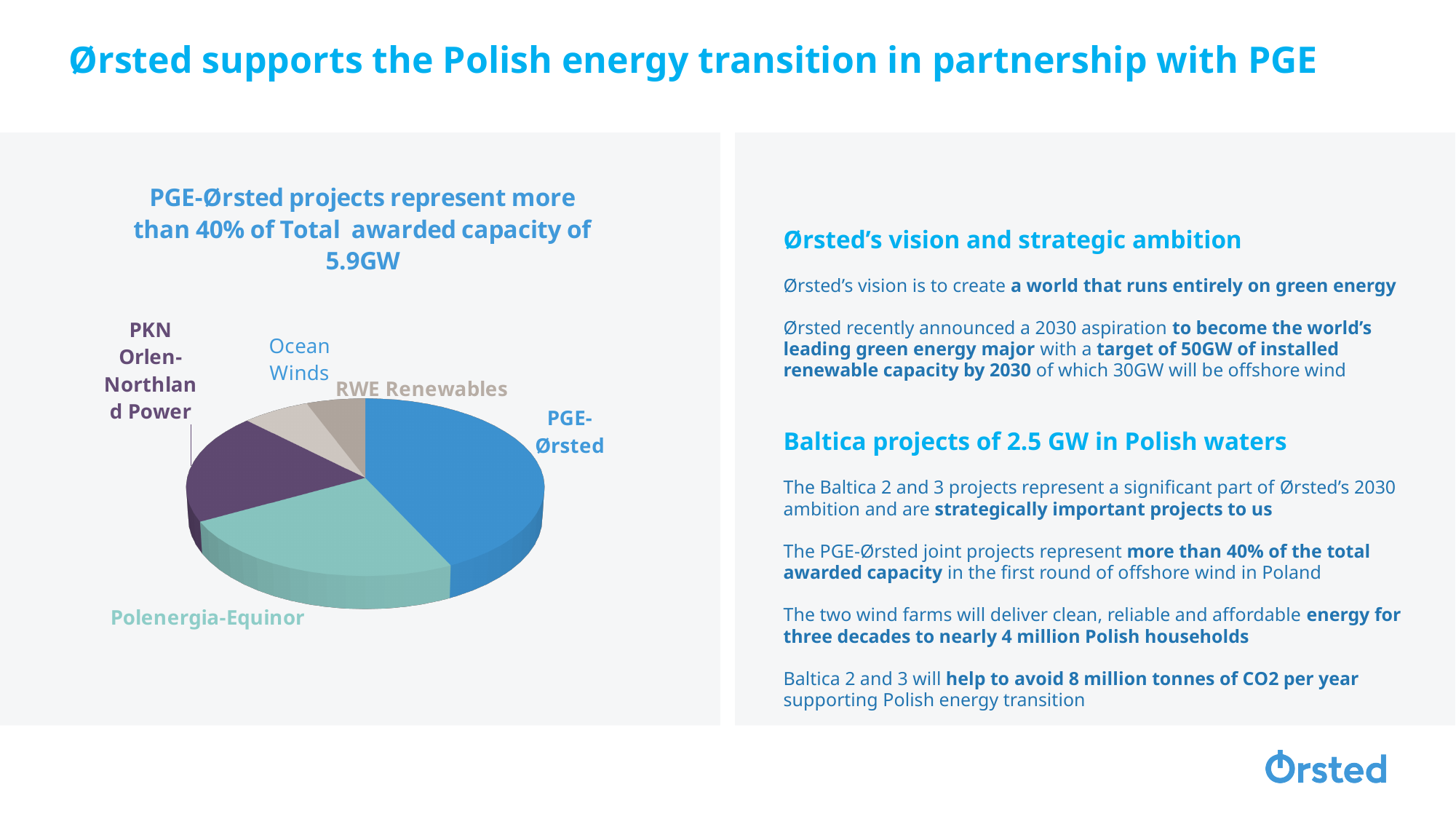
How many slices does the pie chart have? 5 Which is larger in the pie chart, the Polenergia-Equinor slice or the PKN Orlen-Northland Power slice? Polenergia-Equinor Which is larger in the pie chart, the PGE-Ørsted slice or the Polenergia-Equinor slice? PGE-Ørsted Which slice of the pie chart is the largest? PGE-Ørsted Which is larger in the pie chart, the PKN Orlen-Northland Power slice or the Ocean Winds slice? PKN Orlen-Northland Power What colour is the PGE-Ørsted slice in the pie chart? blue According to the chart title, what is the total awarded capacity represented by the pie chart? 5.9GW What kind of chart is shown on the left of the slide? pie chart